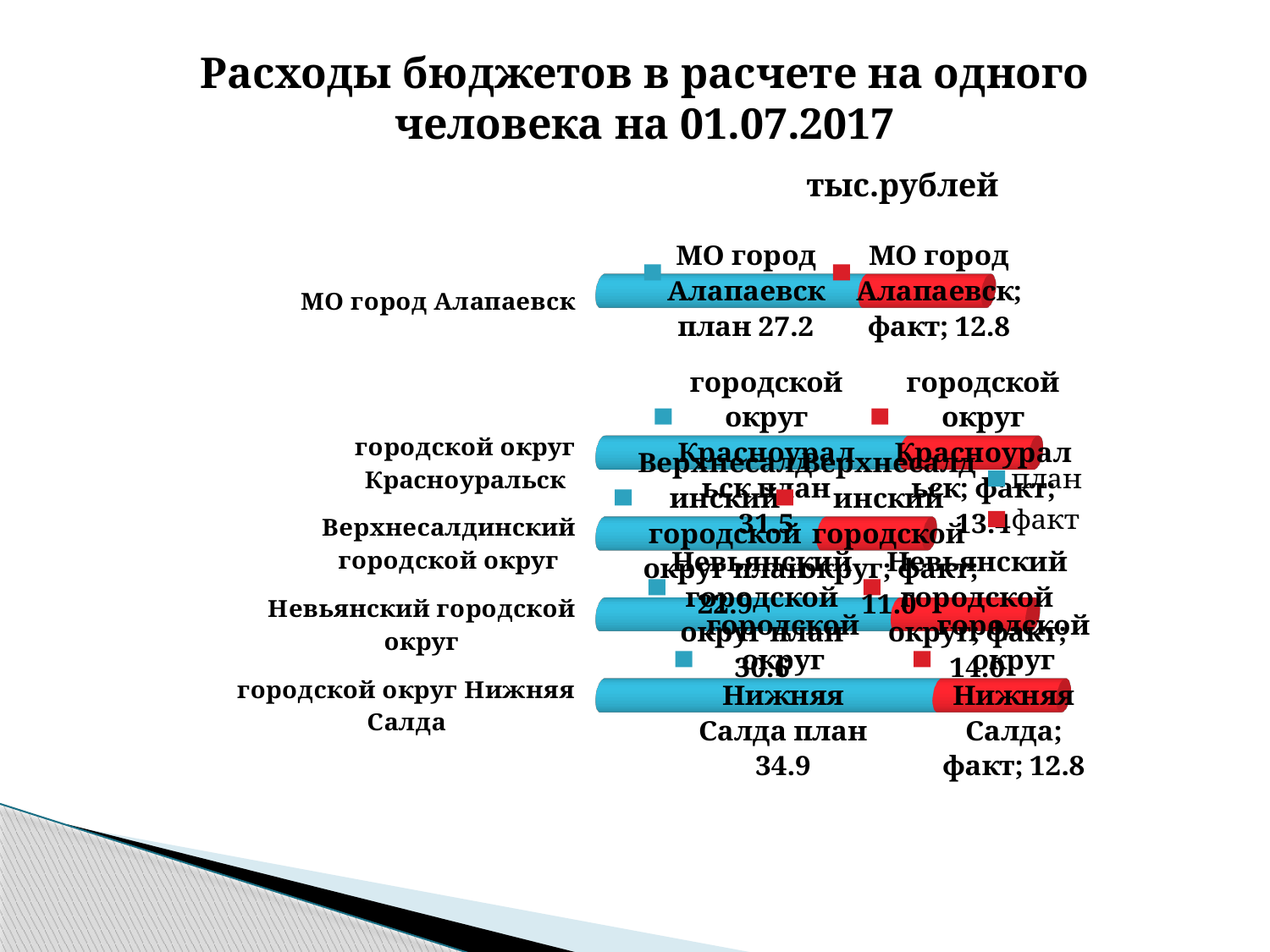
How many series does the legend list? 2 What is the plan value (план) for МО город Алапаевск? 27.2 What type of chart is shown on the slide? bar chart What is the difference between the plan and actual values for МО город Алапаевск? 14.4 What unit of measurement is stated on the slide for the chart values? тыс.рублей How many municipalities (categories) are shown in the chart? 5 What is the actual value (факт) for городской округ Нижняя Салда? 12.8 What is the total of the stacked bar for городской округ Нижняя Салда? 47.7 Which municipality has the highest plan value (план)? городской округ Нижняя Салда What is the plan value (план) for городской округ Нижняя Салда? 34.9 For МО город Алапаевск, which is larger: the plan value or the actual value? план (27.2) What is the actual value (факт) for МО город Алапаевск? 12.8